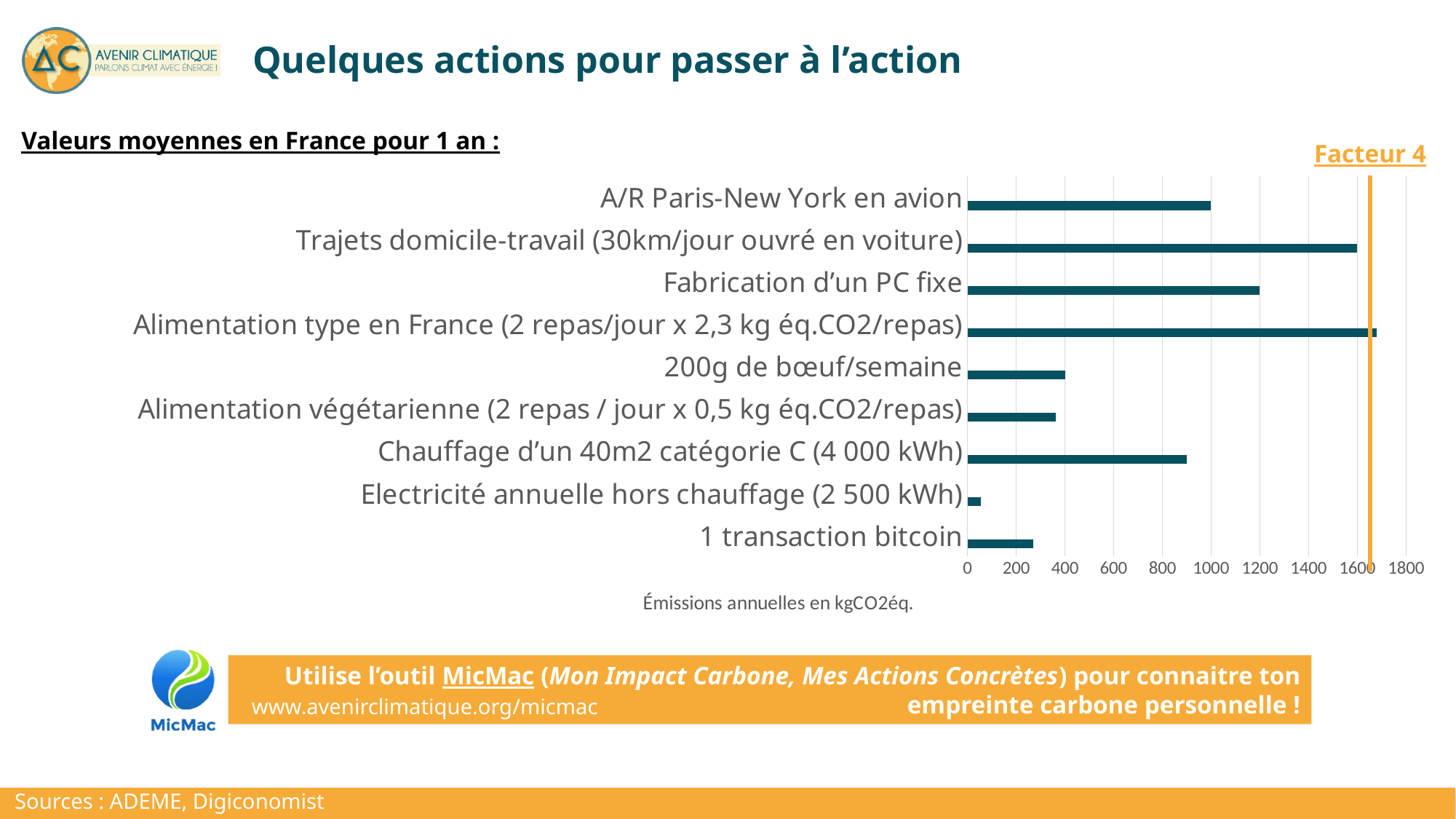
What label is given to the orange vertical line on the chart? Facteur 4 Is the value for '200g de bœuf/semaine' greater or less than 600? less What is the label of the horizontal axis of the chart? Émissions annuelles en kgCO2éq. Which category has the highest annual emissions in the chart? Alimentation type en France (2 repas/jour x 2,3 kg éq.CO2/repas) Is the value for 'Trajets domicile-travail (30km/jour ouvré en voiture)' greater or less than 1400? greater Which category has the lowest annual emissions in the chart? Electricité annuelle hors chauffage (2 500 kWh) Is the value for 'Chauffage d'un 40m2 catégorie C (4 000 kWh)' greater or less than 1000? less What kind of chart is shown on the slide? bar chart How many categories are plotted in the chart? 9 Which is larger: the value for 'Fabrication d'un PC fixe' or the value for 'Alimentation végétarienne (2 repas / jour x 0,5 kg éq.CO2/repas)'? Fabrication d'un PC fixe